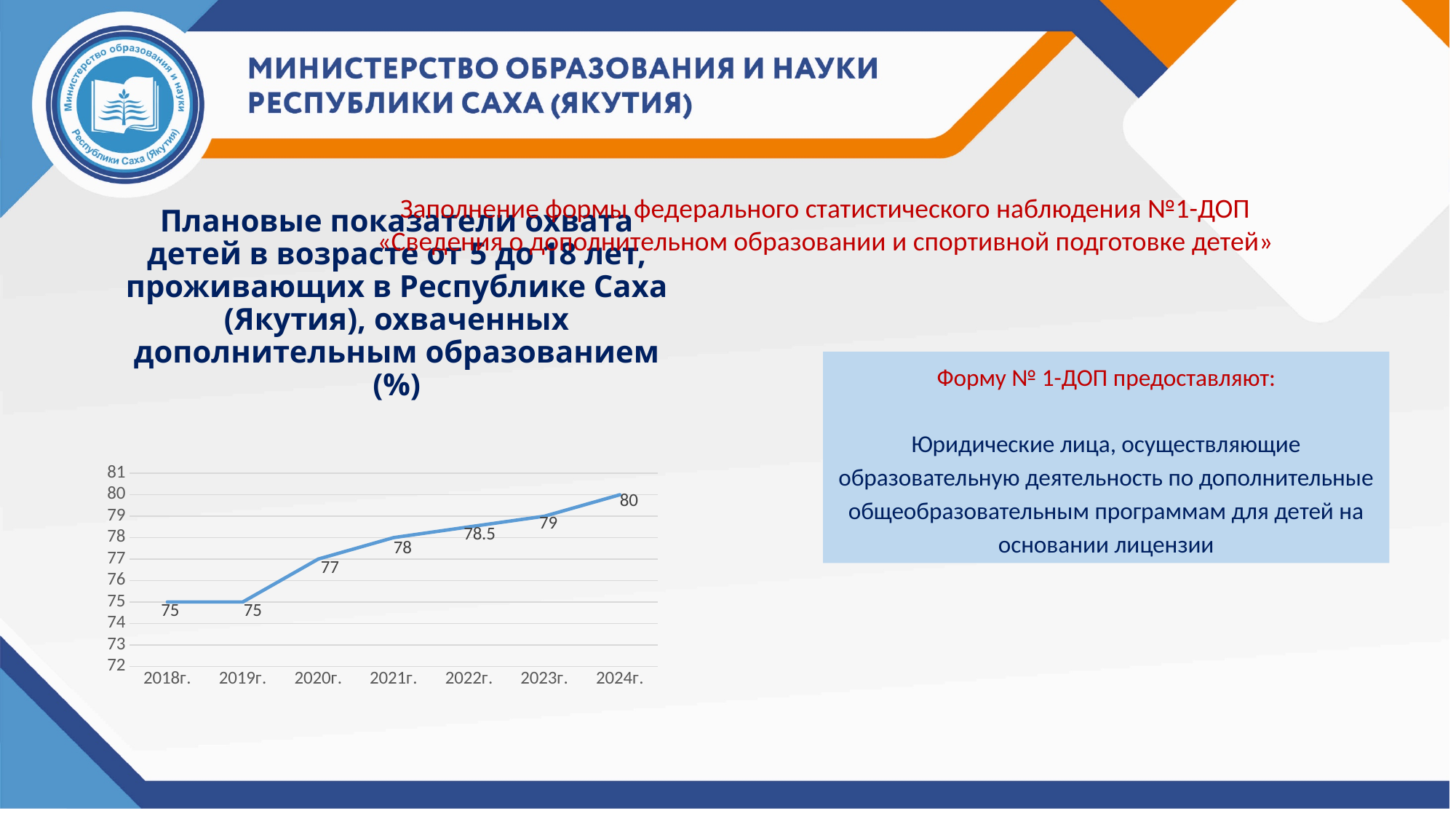
Do the values rise or fall from 2018г. to 2024г.? rise What is the planned coverage value for 2018г.? 75 What is the planned coverage value for 2022г.? 78.5 What type of chart is shown on the slide? line chart How many years are plotted on the x axis? 7 What is the difference between the values for 2023г. and 2021г.? 1 Is the value for 2023г. greater or less than 78? greater What is the difference between the values for 2024г. and 2018г.? 5 What is the planned coverage value for 2024г.? 80 Which is larger, the value for 2021г. or the value for 2019г.? 2021г. Which year has the highest planned coverage value? 2024г. What is the planned coverage value for 2020г.? 77